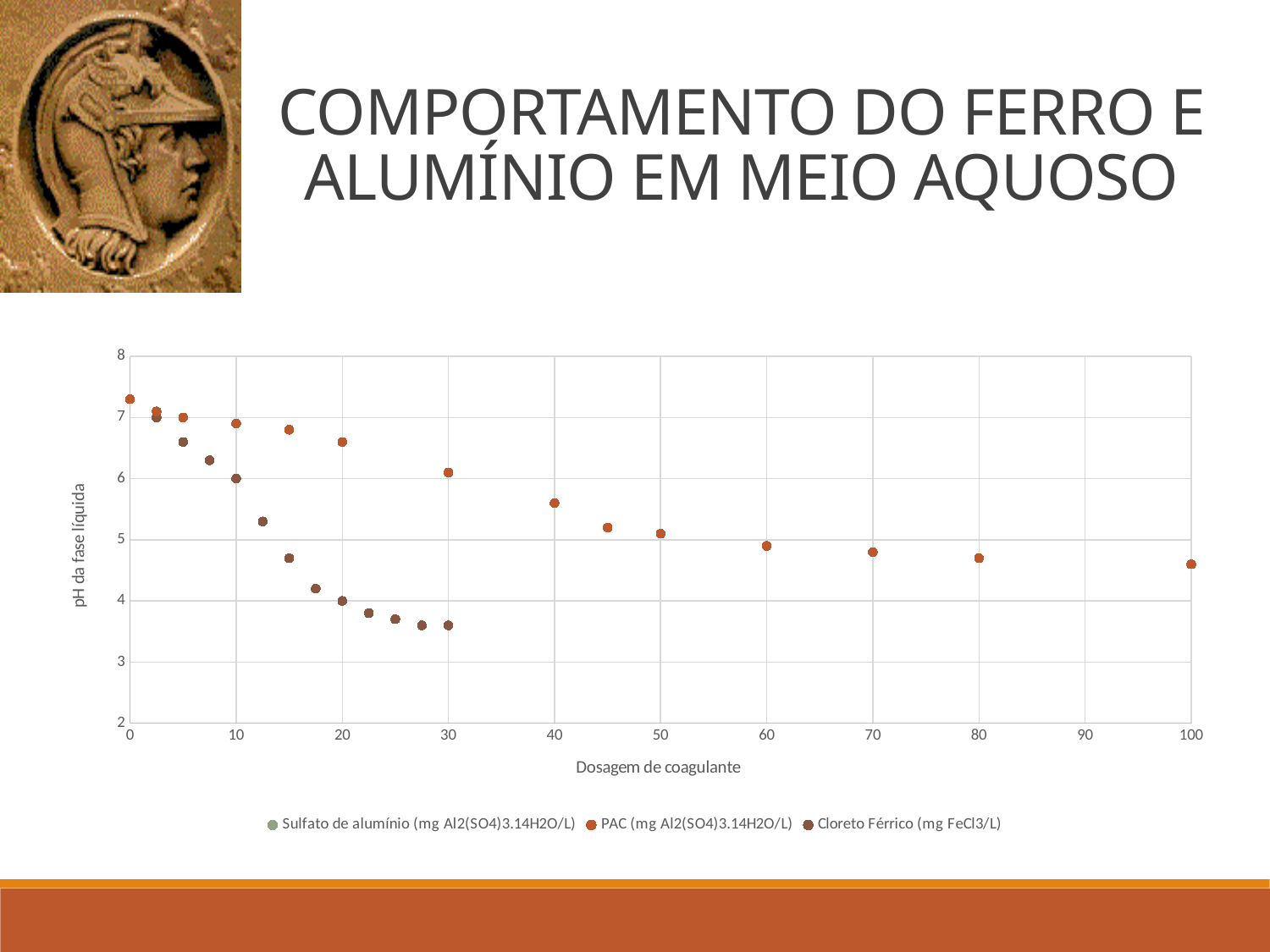
Do the PAC values rise or fall as the coagulant dosage increases along the x axis? fall Is the PAC value at a dosage of 40 greater or less than 5? greater How many series does the chart legend list? 3 At a dosage of 20, which series has the higher pH value, PAC or Cloreto Férrico? PAC Is the PAC value at a dosage of 0 greater or less than 7? greater What is the title of the chart's x axis? Dosagem de coagulante Is the PAC value at a dosage of 100 greater or less than 5? less What kind of chart is shown on the slide? scatter chart What is the title of the chart's y axis? pH da fase líquida What is the highest value shown on the chart's x axis? 100 Do the Cloreto Férrico values rise or fall as the coagulant dosage increases along the x axis? fall